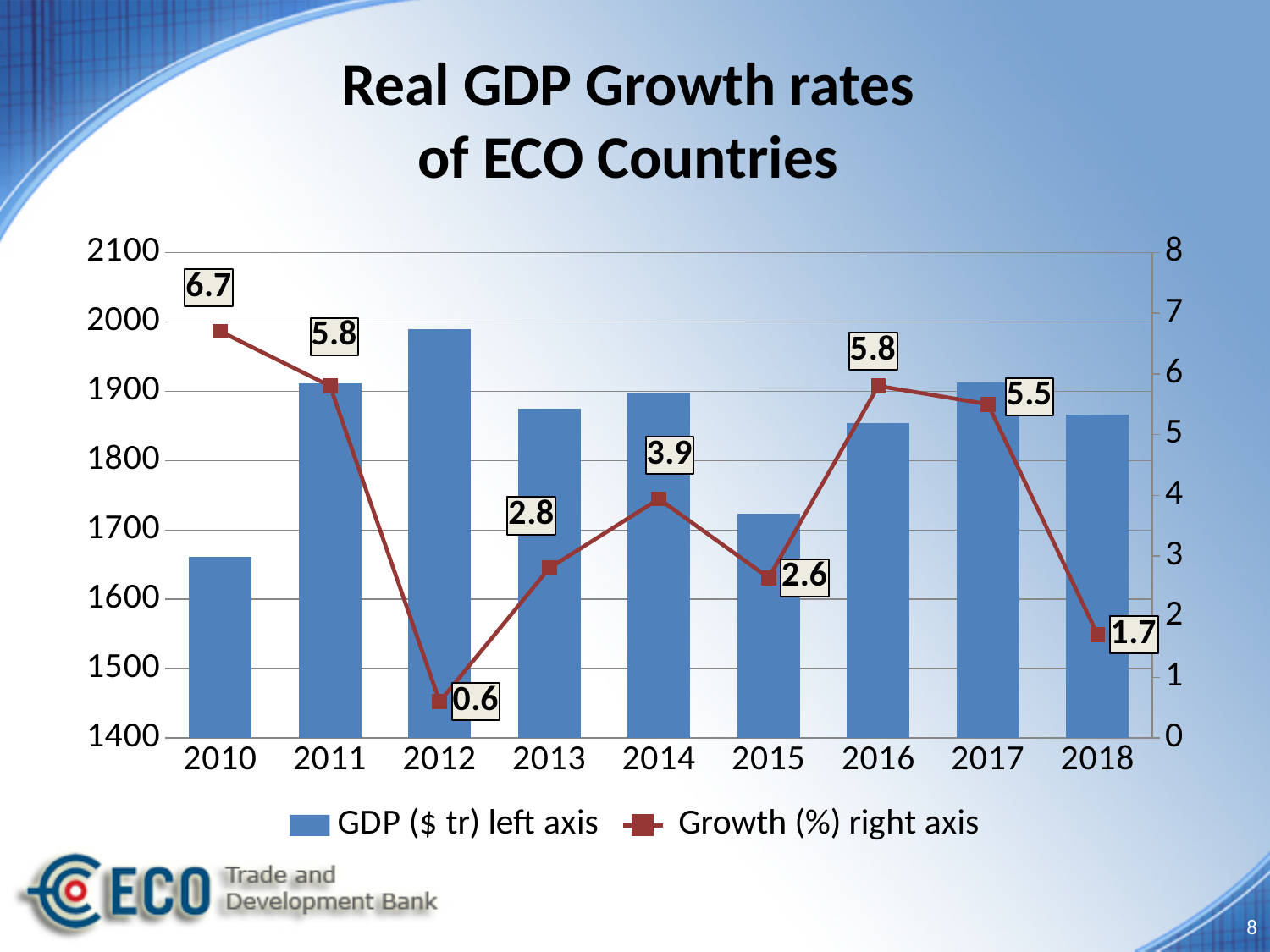
What is the Growth (%) value for 2010? 6.7 How many series does the legend list? 2 What is the Growth (%) value for 2018? 1.7 Is the GDP ($ tr) bar for 2012 greater or less than 1900? greater What kind of chart is shown on the slide? Combination bar and line chart What is the difference between the Growth (%) values for 2010 and 2012? 6.1 What is the Growth (%) value for 2014? 3.9 Which year has a higher Growth (%) value, 2014 or 2015? 2014 How many years are shown on the x axis? 9 Which year has the highest Growth (%) value? 2010 Which year has the lowest Growth (%) value? 2012 Is the GDP ($ tr) bar for 2010 greater or less than 1700? less